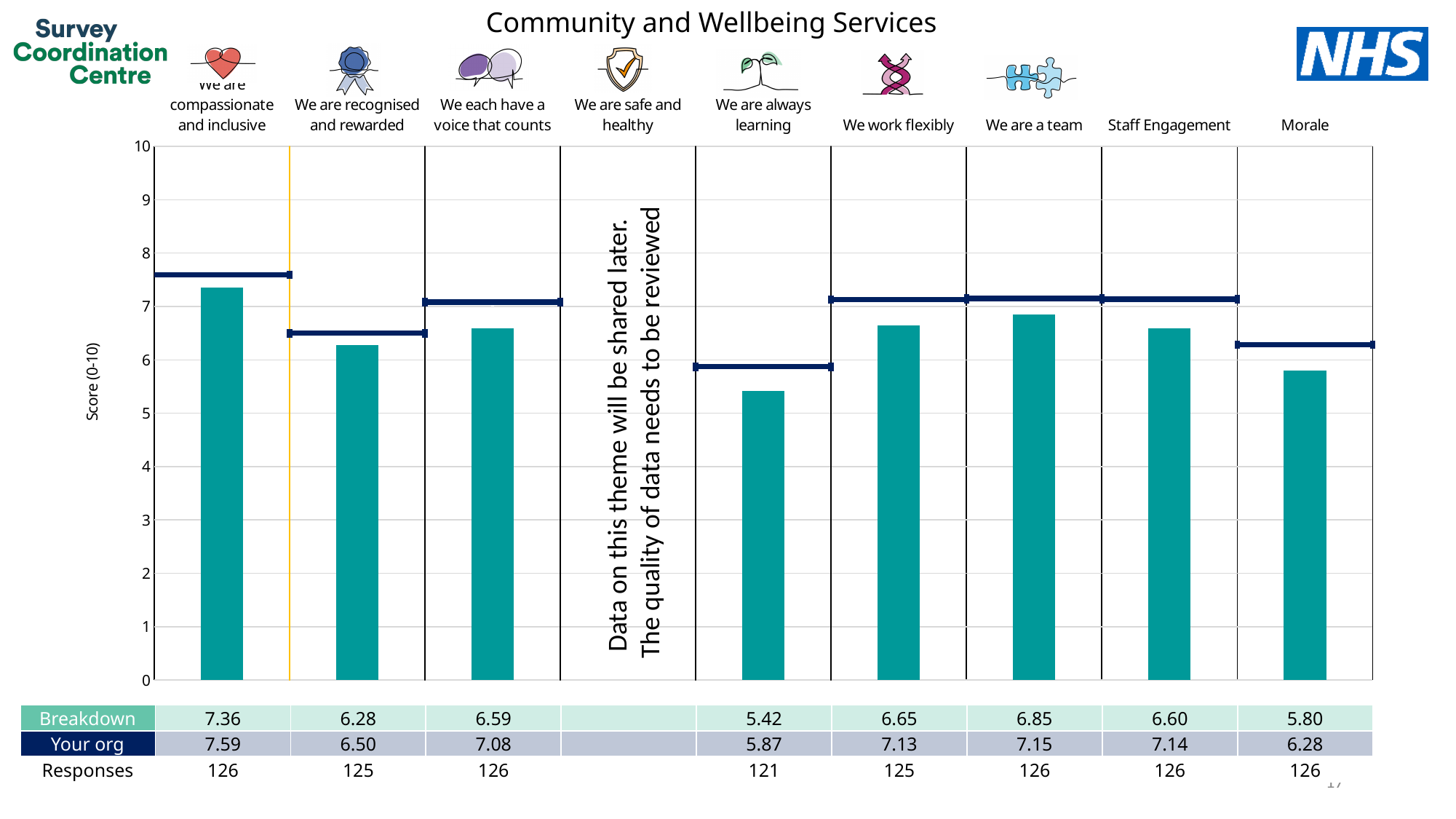
What is the difference between the Your org score and the Breakdown score for Morale? 0.48 What kind of chart is shown on the slide? bar chart What is the Your org score for 'We work flexibly'? 7.13 Which has the higher Breakdown score: 'We are a team' or 'We each have a voice that counts'? We are a team Which theme has no data plotted on the chart? We are safe and healthy Is the Breakdown bar for 'We are always learning' greater or less than 6? less Which theme has the highest Breakdown score? We are compassionate and inclusive Which theme has the lowest Breakdown score? We are always learning What is the title of the chart? Community and Wellbeing Services What is the Breakdown score for 'We are compassionate and inclusive'? 7.36 How many teal Breakdown bars are plotted on the chart? 8 How many responses are recorded for 'We are always learning'? 121